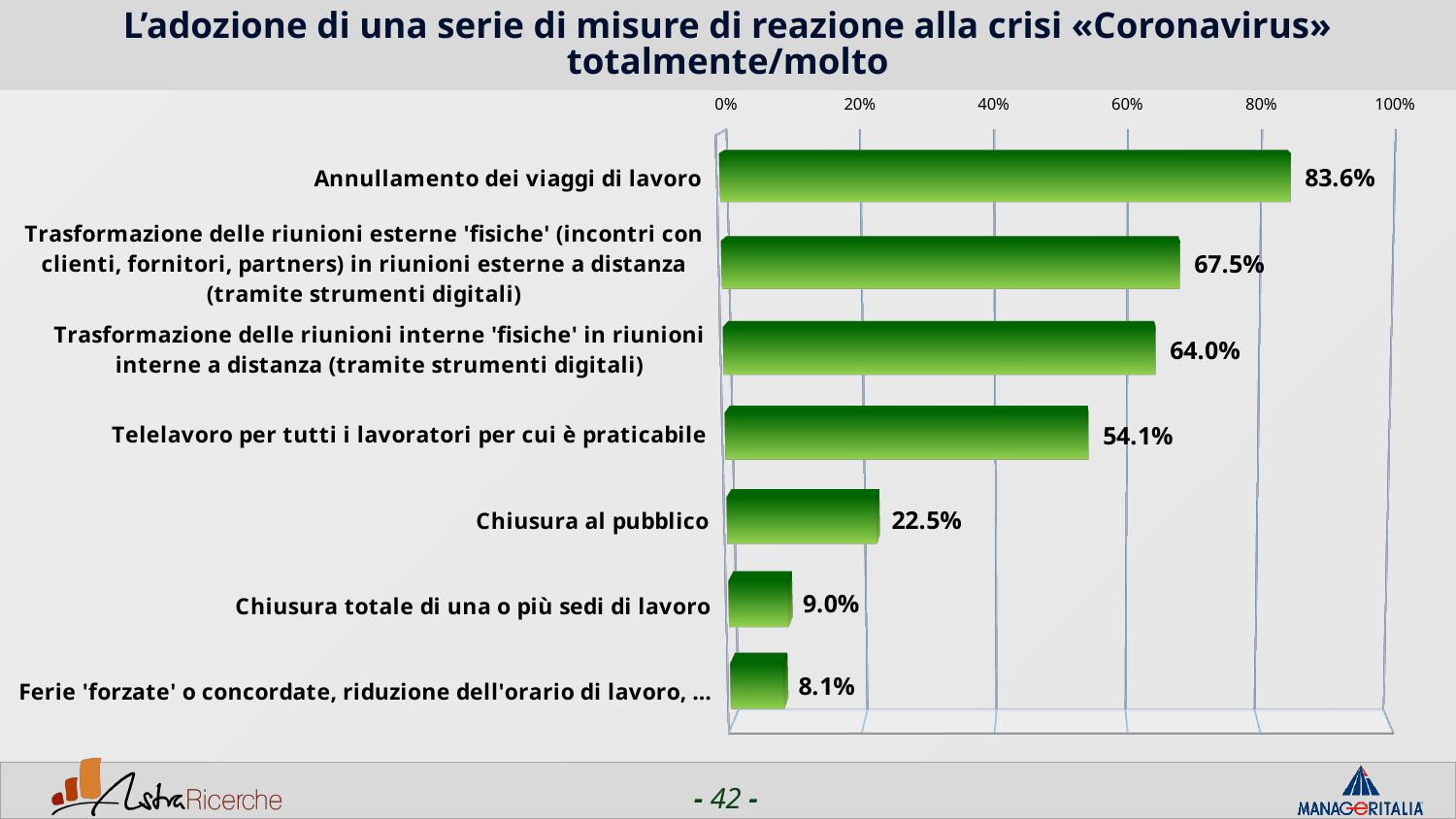
What kind of chart is shown on the slide? Bar chart What is the value for 'Telelavoro per tutti i lavoratori per cui è praticabile'? 54.1% Which category has the lowest value? Ferie 'forzate' o concordate, riduzione dell'orario di lavoro, … What is the difference between the values for 'Trasformazione delle riunioni esterne 'fisiche' (incontri con clienti, fornitori, partners) in riunioni esterne a distanza (tramite strumenti digitali)' and 'Trasformazione delle riunioni interne 'fisiche' in riunioni interne a distanza (tramite strumenti digitali)'? 3.5% What is the value for 'Chiusura totale di una o più sedi di lavoro'? 9.0% What is the value for 'Annullamento dei viaggi di lavoro'? 83.6% What is the difference between the values for 'Annullamento dei viaggi di lavoro' and 'Telelavoro per tutti i lavoratori per cui è praticabile'? 29.5% Which category has the highest value? Annullamento dei viaggi di lavoro Is the value for 'Trasformazione delle riunioni interne 'fisiche' in riunioni interne a distanza (tramite strumenti digitali)' greater or less than 60%? greater What is the value for 'Chiusura al pubblico'? 22.5% Which is larger: the value for 'Chiusura al pubblico' or the value for 'Chiusura totale di una o più sedi di lavoro'? Chiusura al pubblico How many categories are shown in the chart? 7